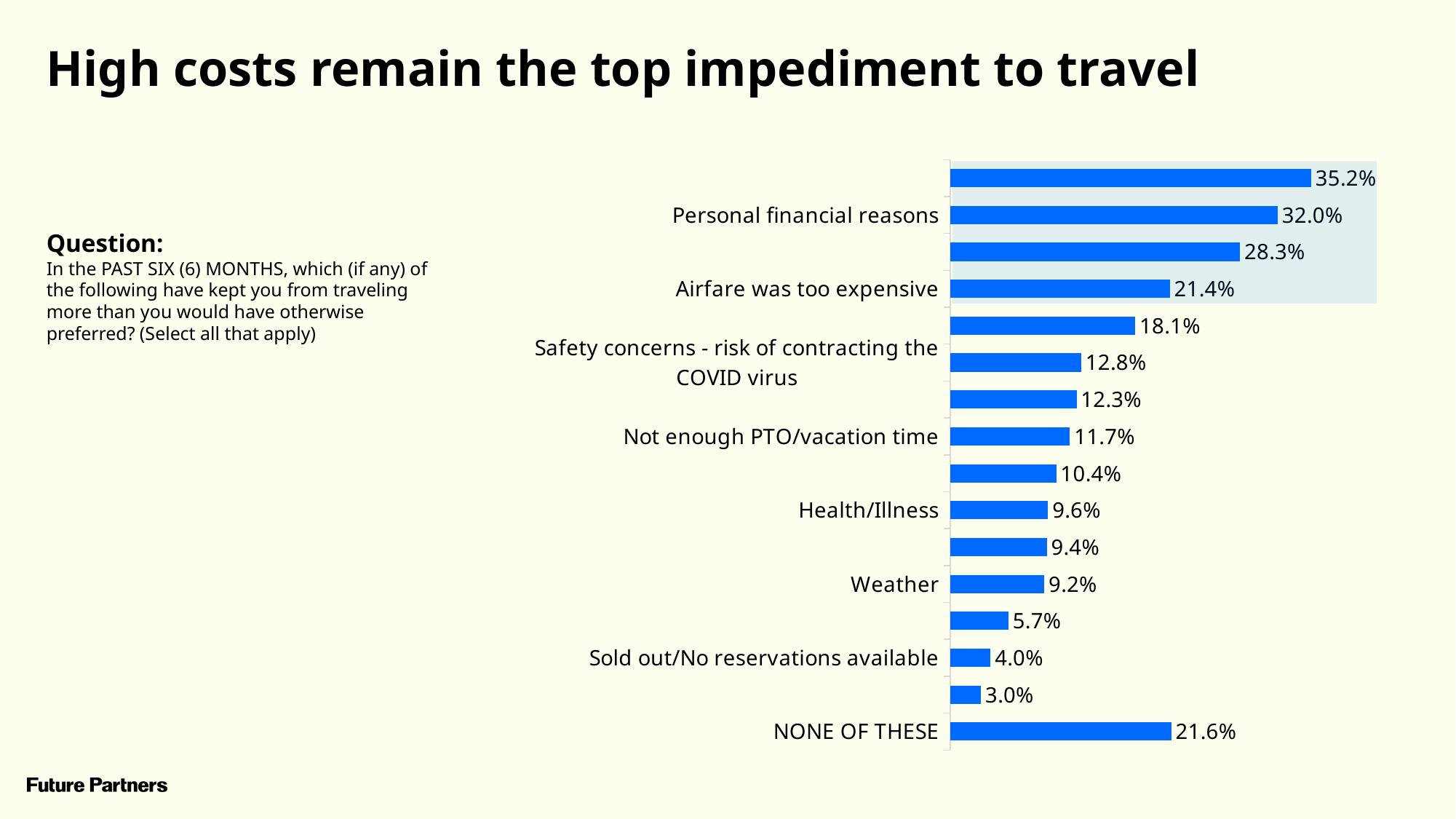
What percentage of respondents selected "Personal financial reasons"? 32.0% What type of chart is shown on the slide? Bar chart Which has a larger value, "Health/Illness" or "Sold out/No reservations available"? Health/Illness What value is shown for "Airfare was too expensive"? 21.4% What percentage is shown for "Safety concerns - risk of contracting the COVID virus"? 12.8% What percentage is shown for "NONE OF THESE"? 21.6% What is the lowest value shown on the chart? 3.0% What is the difference between the values for "Personal financial reasons" and "Airfare was too expensive"? 10.6 percentage points What is the title of the slide? High costs remain the top impediment to travel What is the highest value shown on the chart? 35.2% What value is shown for "Not enough PTO/vacation time"? 11.7% How many bars are plotted on the chart? 16